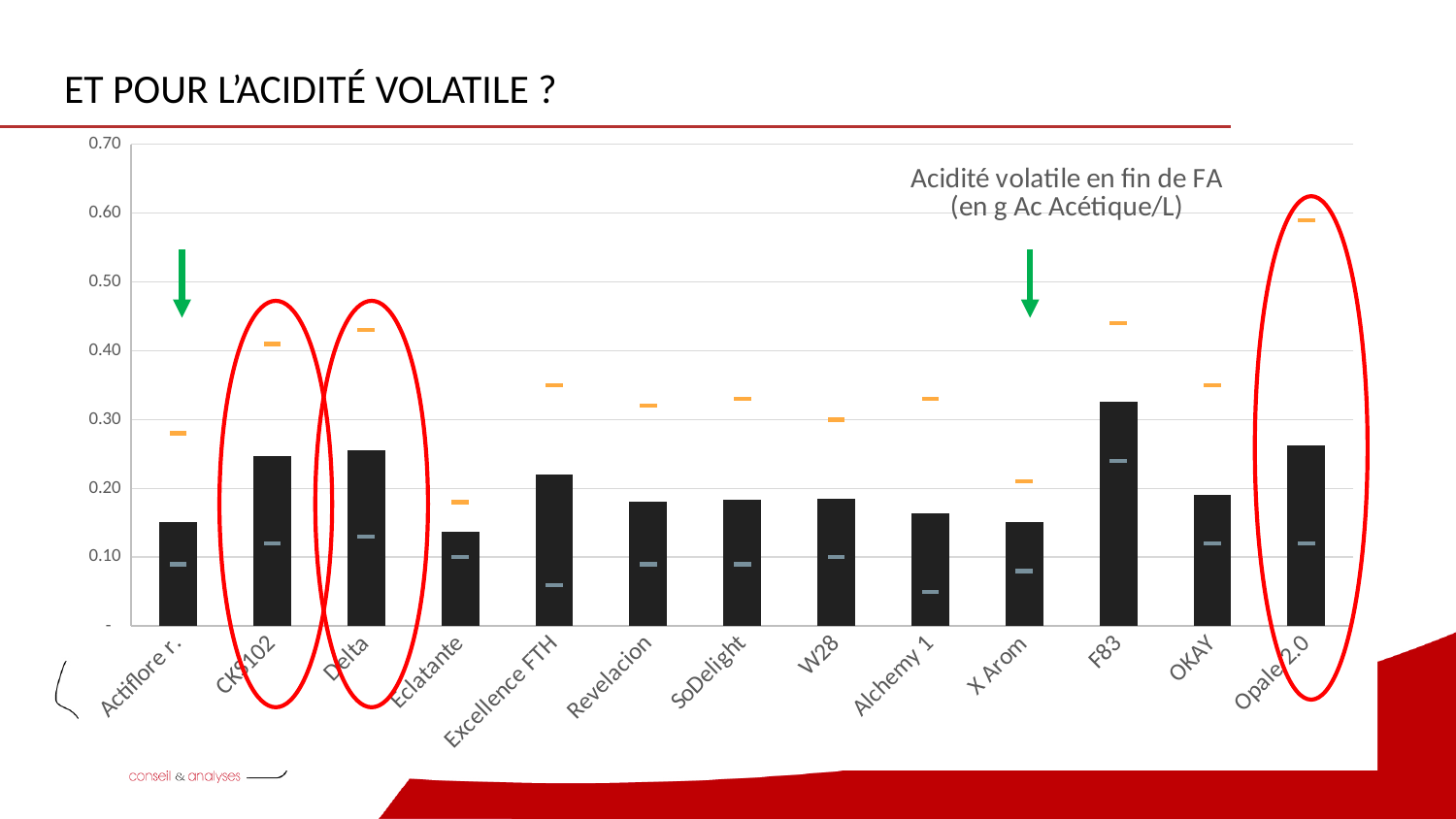
Which has the taller black bar, F83 or OKAY? F83 Which category has the tallest black bar in the chart? F83 What unit is given in the chart annotation for volatile acidity? g Ac Acétique/L Which category has the highest orange marker in the chart? Opale 2.0 Is the orange marker for Opale 2.0 greater or less than 0.50? greater Is the black bar for Excellence FTH greater or less than 0.20? greater Is the black bar for Eclatante greater or less than 0.20? less Which has the taller black bar, CKS102 or Eclatante? CKS102 Which category has the lowest orange marker in the chart? Eclatante What kind of chart is shown on the slide? bar chart How many categories (yeast strains) are shown on the x axis of the chart? 13